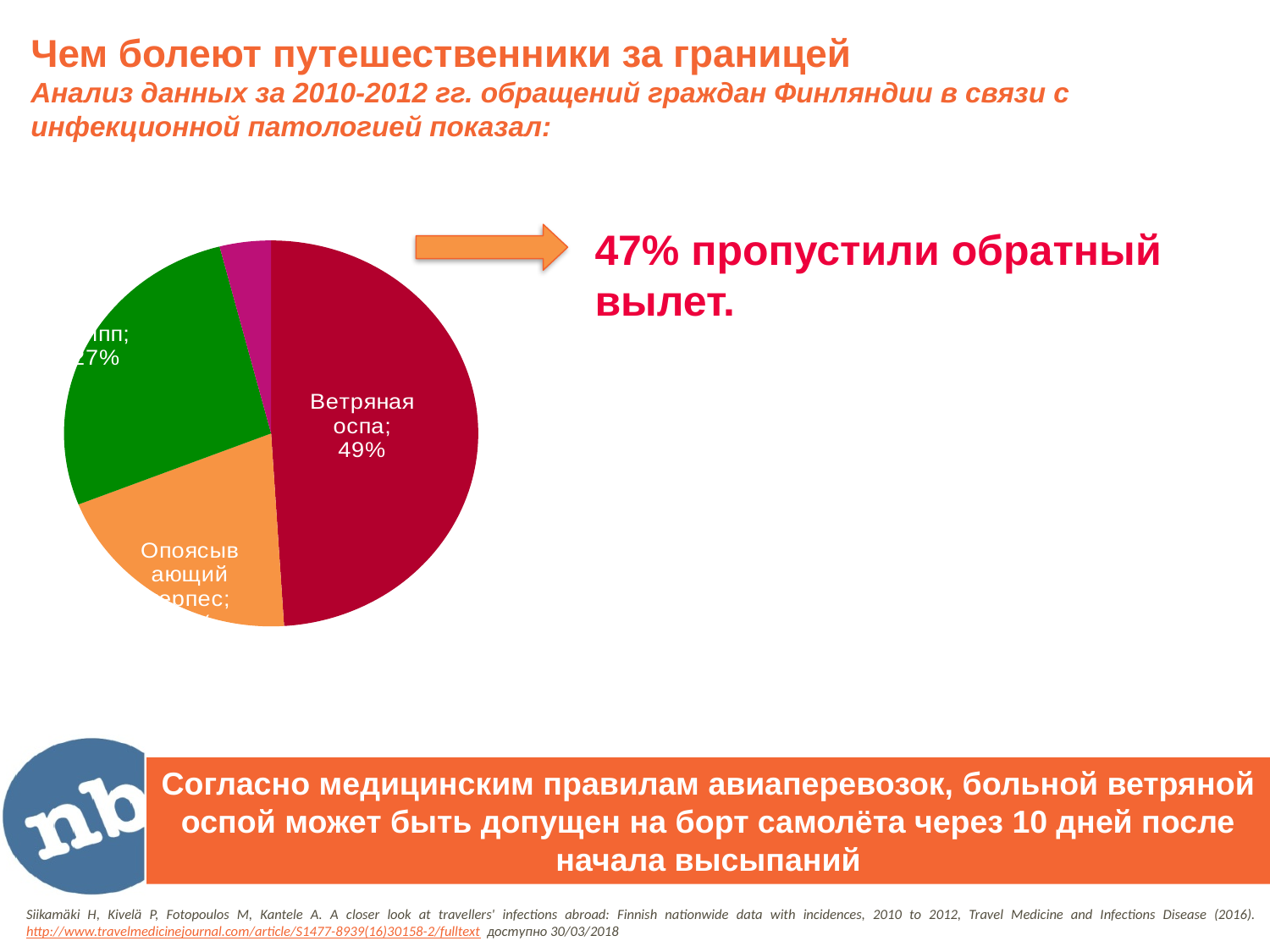
What colour is the Ветряная оспа slice? red What colour is the smallest slice of the pie? magenta What share of the pie does Ветряная оспа account for? 49% Which category has the largest slice of the pie? Ветряная оспа Which slice is larger, Ветряная оспа or Опоясывающий герпес? Ветряная оспа Which slice is larger, the green slice or the orange slice? the green slice What kind of chart is shown on the slide? pie chart How many slices does the pie chart have? 4 Is the share for Ветряная оспа greater or less than 40%? greater